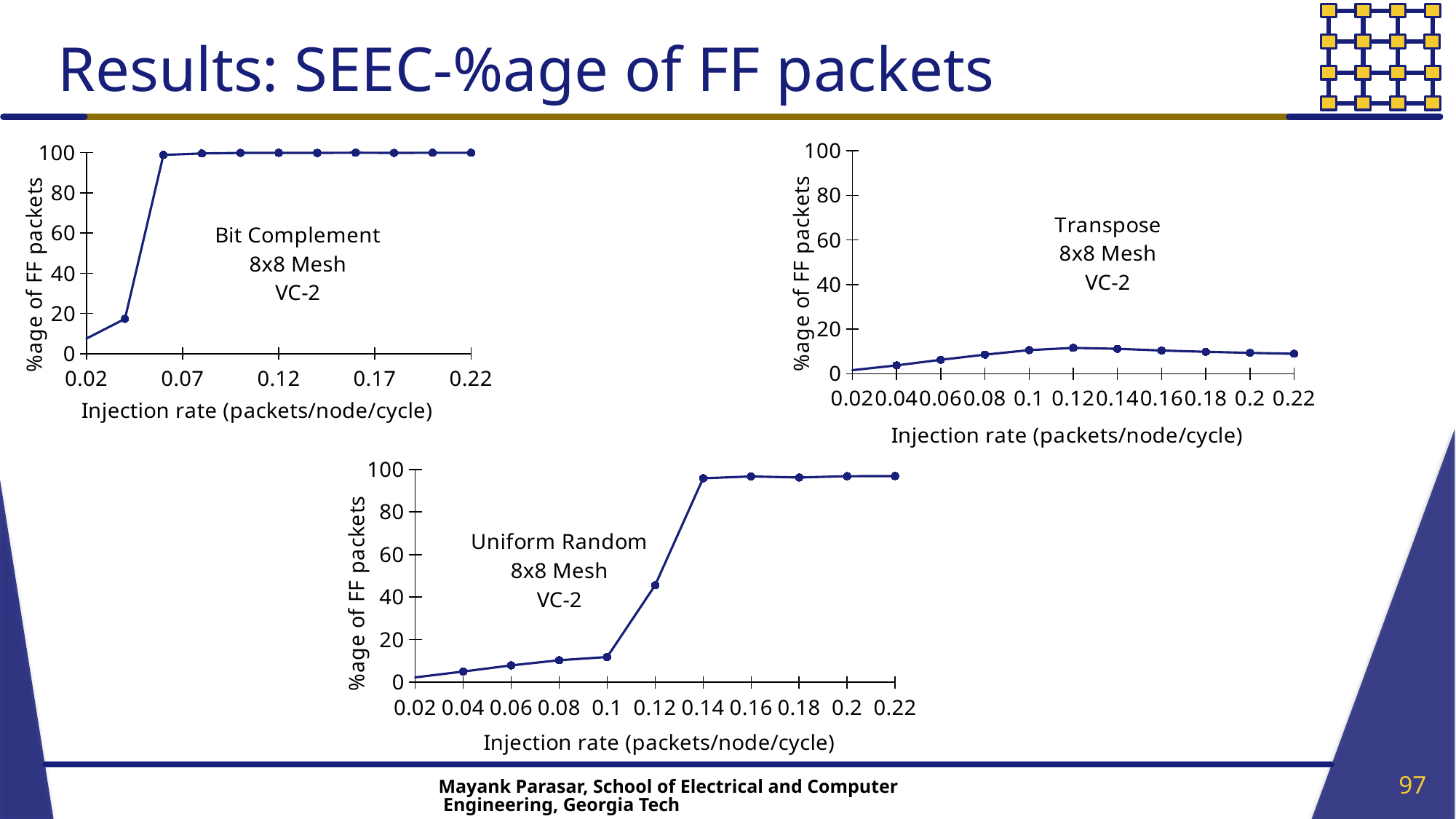
What is the y-axis label of the Transpose chart? %age of FF packets In the Bit Complement chart, how many data points are plotted? 11 In the Uniform Random chart, is the value at injection rate 0.12 greater or less than 60? less In the Bit Complement chart, is the value at injection rate 0.22 greater or less than 80? greater In the Transpose chart, how many data points are plotted? 11 In the Transpose chart, is the value at injection rate 0.12 greater or less than 20? less In the Uniform Random chart, which injection rate has the larger value, 0.1 or 0.14? 0.14 What kind of chart is the Bit Complement 8x8 Mesh VC-2 chart? line chart In the Uniform Random chart, do the values generally rise or fall as the injection rate increases from 0.02 to 0.14? rise What is the x-axis label of the Uniform Random chart? Injection rate (packets/node/cycle)